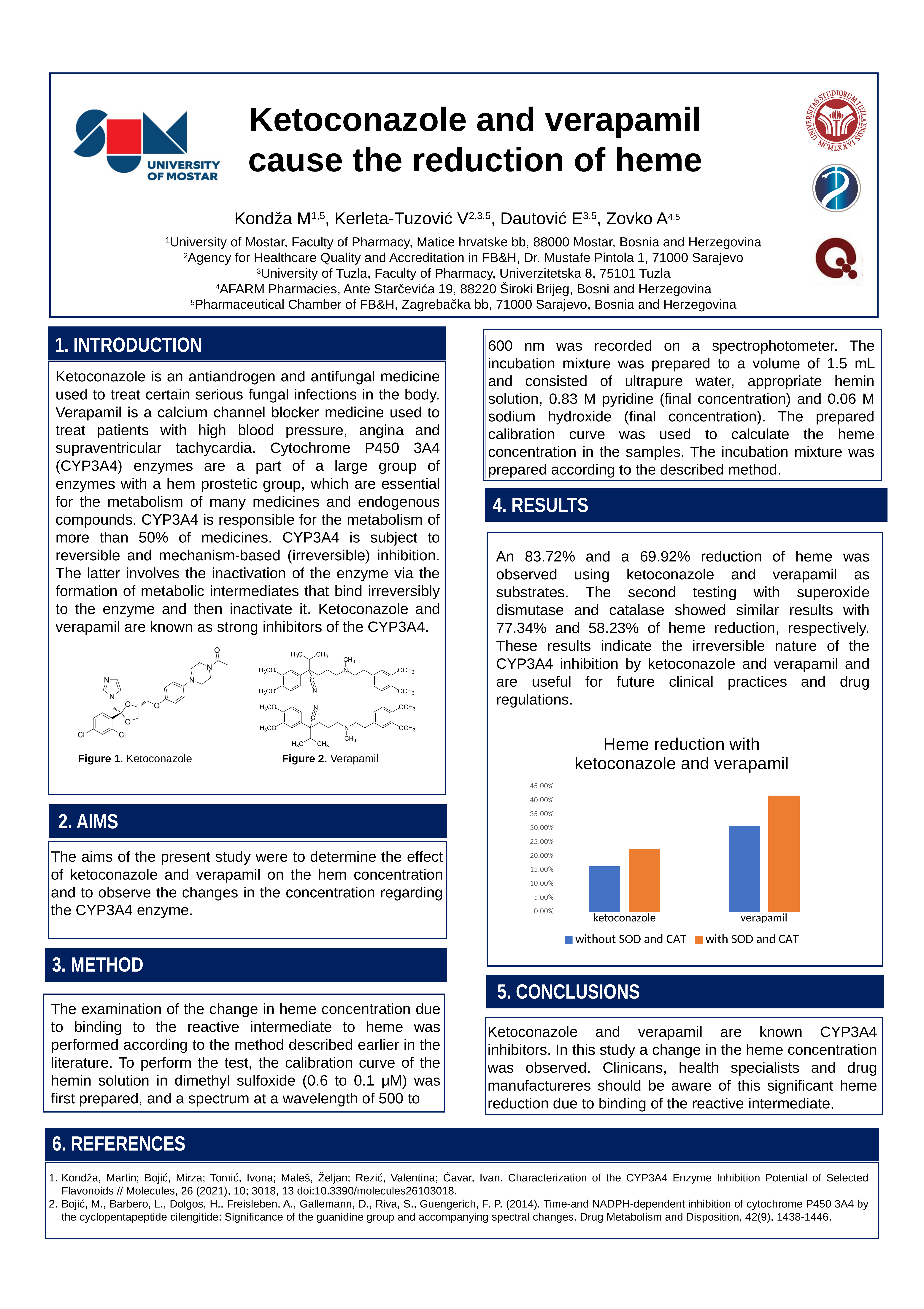
What kind of chart is shown under the title "Heme reduction with ketoconazole and verapamil"? bar chart In the "Heme reduction with ketoconazole and verapamil" chart, which is larger for verapamil: the "without SOD and CAT" bar or the "with SOD and CAT" bar? with SOD and CAT In the "Heme reduction with ketoconazole and verapamil" chart, is the "with SOD and CAT" value for verapamil greater or less than 40.00%? greater In the "Heme reduction with ketoconazole and verapamil" chart, is the "without SOD and CAT" value for ketoconazole greater or less than 20.00%? less In the "Heme reduction with ketoconazole and verapamil" chart, which category has the larger "without SOD and CAT" value, ketoconazole or verapamil? verapamil In the "Heme reduction with ketoconazole and verapamil" chart, which category has the tallest bar overall? verapamil How many categories are shown on the x axis of the "Heme reduction with ketoconazole and verapamil" chart? 2 How many series does the legend of the "Heme reduction with ketoconazole and verapamil" chart list? 2 In the "Heme reduction with ketoconazole and verapamil" chart, which bar is the lowest? ketoconazole, without SOD and CAT In the "Heme reduction with ketoconazole and verapamil" chart, is the "with SOD and CAT" value for ketoconazole greater or less than 20.00%? greater In the "Heme reduction with ketoconazole and verapamil" chart, what colour are the "with SOD and CAT" bars? orange